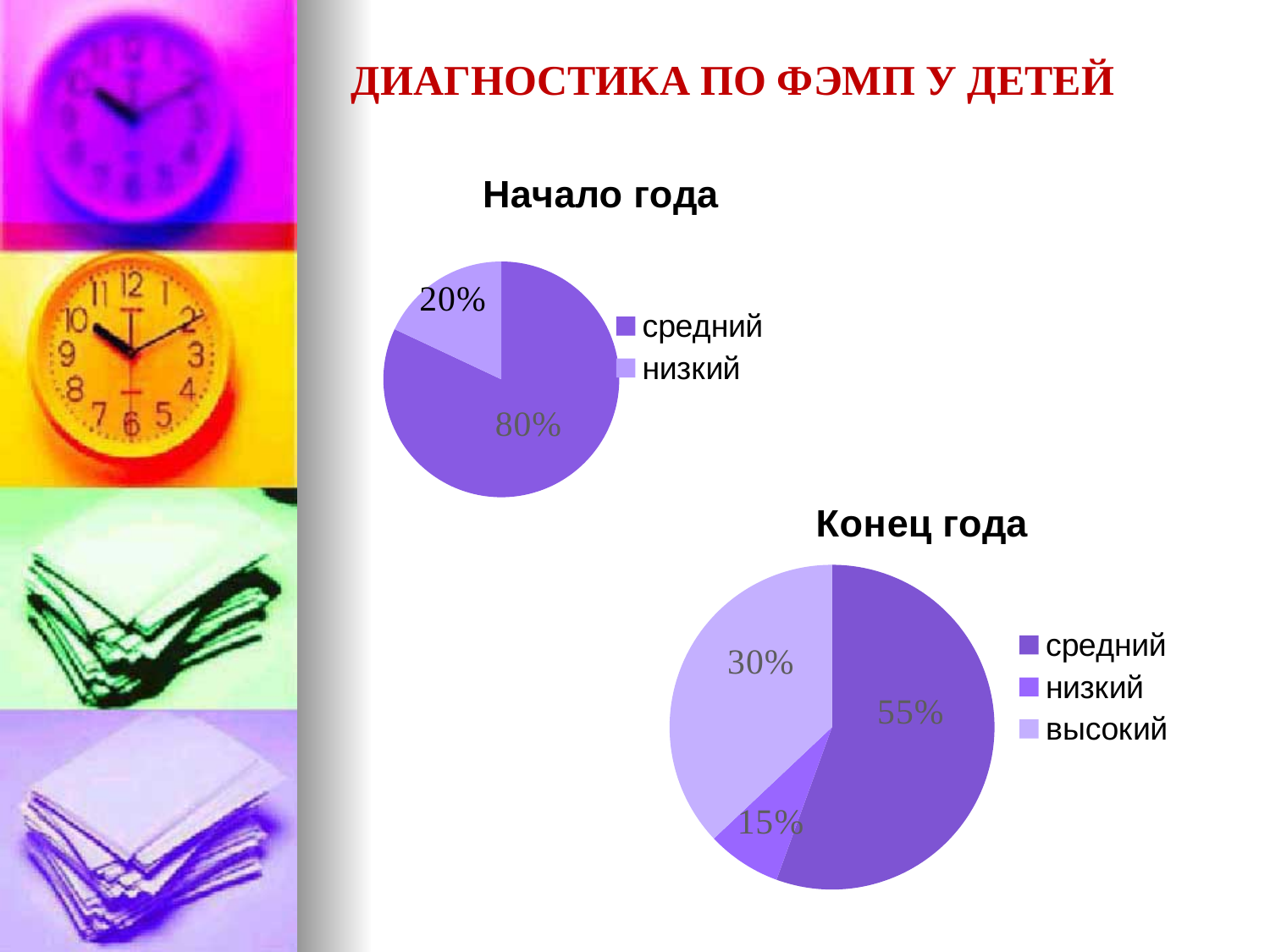
What type of chart is the "Конец года" chart? pie chart In the "Конец года" chart, which category has the smallest slice? низкий In the "Начало года" chart, what is the difference between the средний and низкий shares? 60% How many slices does the "Начало года" chart have? 2 How many entries does the legend of the "Конец года" chart list? 3 In the "Конец года" chart, what share is labelled for средний? 55% In the "Начало года" chart, what share is labelled for средний? 80% In the "Конец года" chart, which category has the largest slice? средний In the "Начало года" chart, what share is labelled for низкий? 20% In the "Конец года" chart, what share is labelled for низкий? 15% In the "Конец года" chart, which is larger, the share for высокий or the share for низкий? высокий In the "Конец года" chart, what share is labelled for высокий? 30%